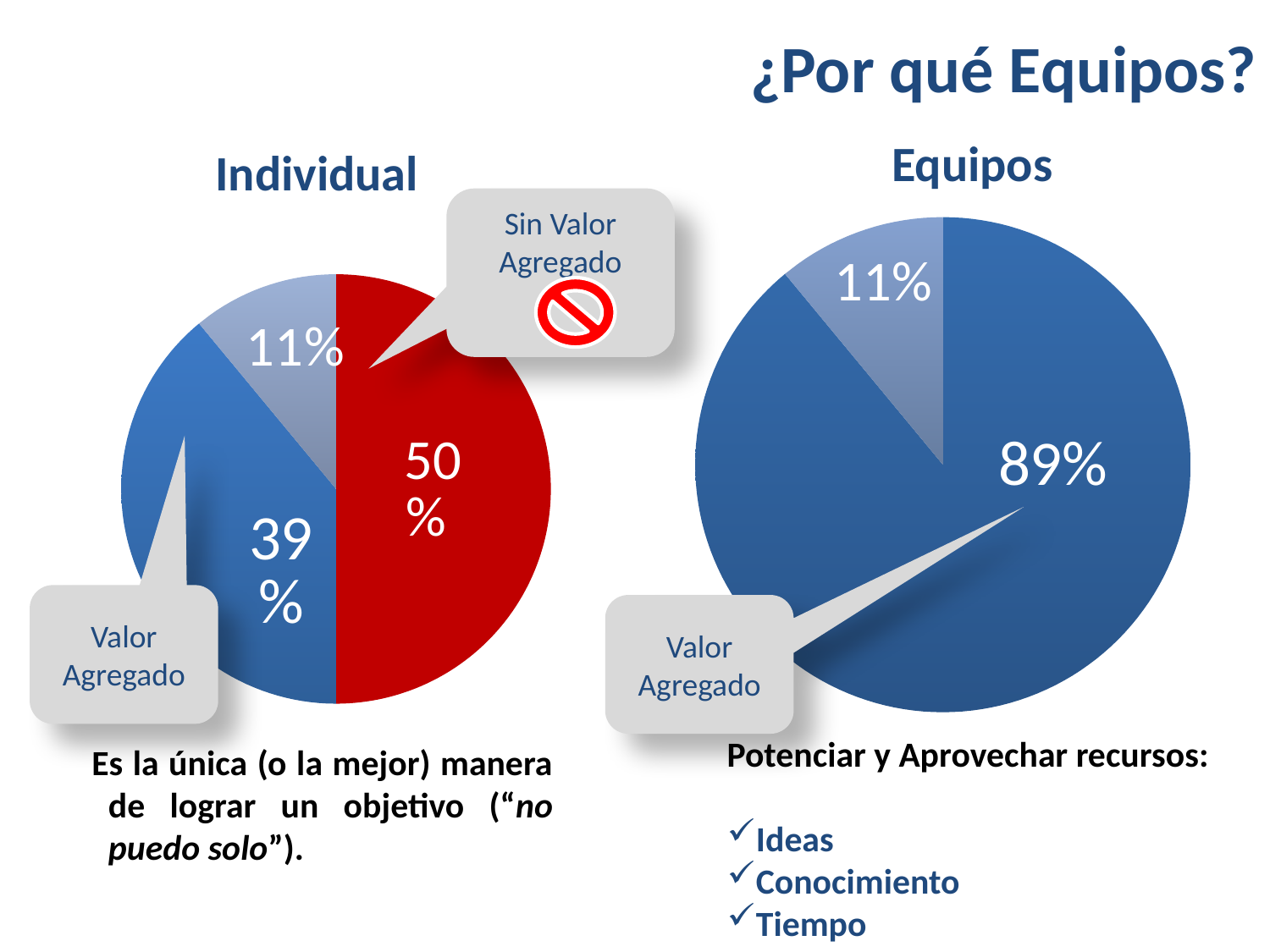
What kind of charts are shown on the slide? Pie charts How many slices does the Equipos pie chart have? 2 In the Individual pie chart, what is the difference between the "Sin Valor Agregado" slice and the "Valor Agregado" slice? 11% How many slices does the Individual pie chart have? 3 In the Individual pie chart, what percentage is shown for the small light-blue slice? 11% What is the difference between the "Valor Agregado" slice in the Equipos chart and the "Valor Agregado" slice in the Individual chart? 50% In the Individual pie chart, which slice is the largest? Sin Valor Agregado (50%) In the Individual pie chart, what percentage is shown for the slice labelled "Valor Agregado"? 39% In the Individual pie chart, what percentage is shown for the red slice labelled "Sin Valor Agregado"? 50% In the Equipos pie chart, what percentage is shown for the slice labelled "Valor Agregado"? 89% Which is larger: the "Valor Agregado" slice in the Individual chart or the "Valor Agregado" slice in the Equipos chart? Equipos In the Equipos pie chart, what percentage is shown for the small light-blue slice? 11%